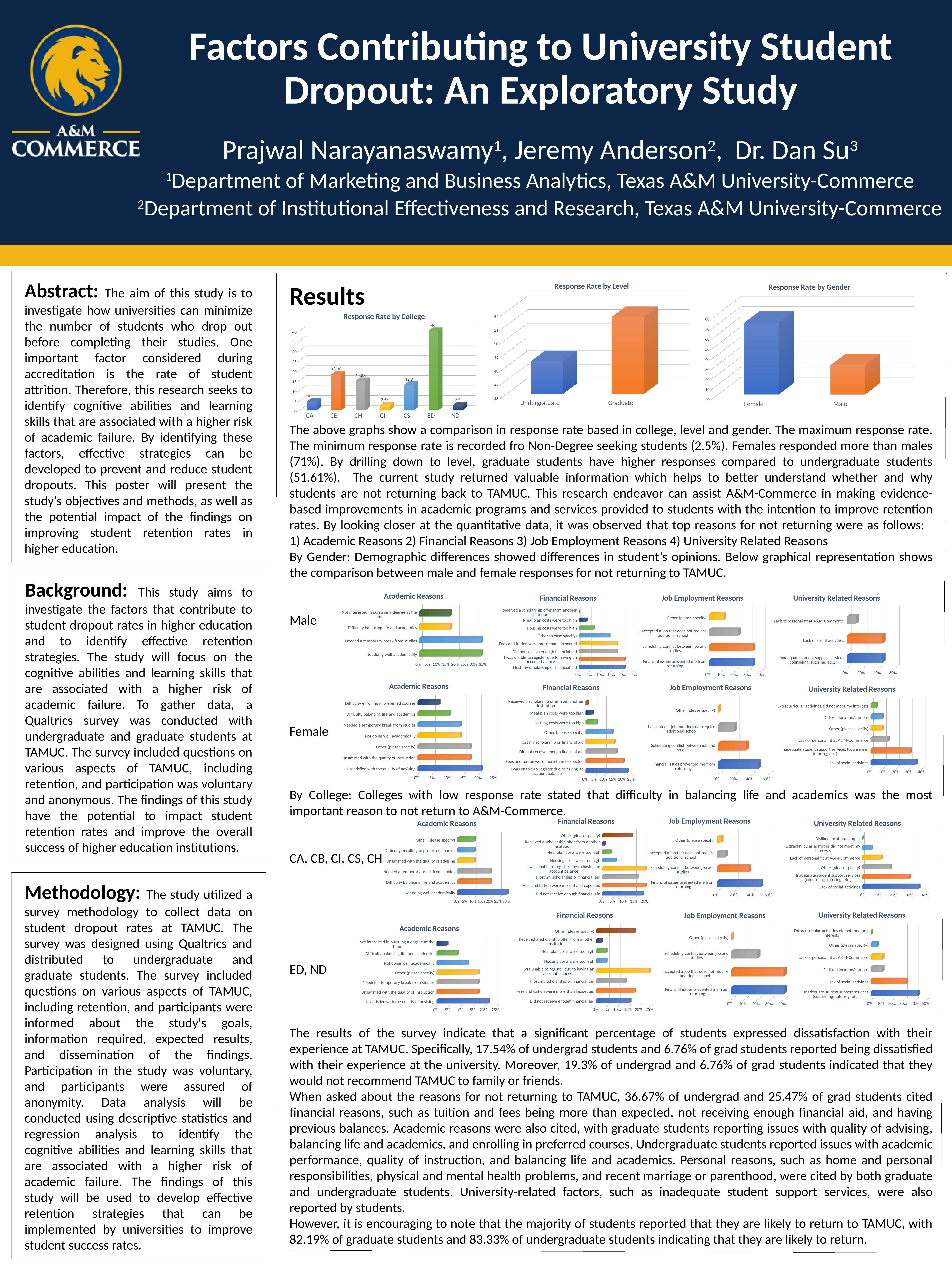
What kind of chart is the Response Rate by College chart? Bar chart In the Response Rate by College chart, what is the value for CB? 18.06 How many colleges are shown in the Response Rate by College chart? 7 In the Response Rate by College chart, which college has the lowest response rate? ND In the Response Rate by College chart, what is the value for CA? 4.51 In the Response Rate by College chart, what is the value for ED? 40 In the Response Rate by Gender chart, is the value for Male greater or less than 40? less In the Response Rate by Gender chart, which is larger, the value for Female or the value for Male? Female In the Response Rate by College chart, what is the difference between the values for ED and CB? 21.94 In the Response Rate by College chart, which college has the highest response rate? ED In the Response Rate by Level chart, is the value for Graduate greater or less than 50? greater In the Response Rate by College chart, which is larger, the value for CH or the value for CS? CH